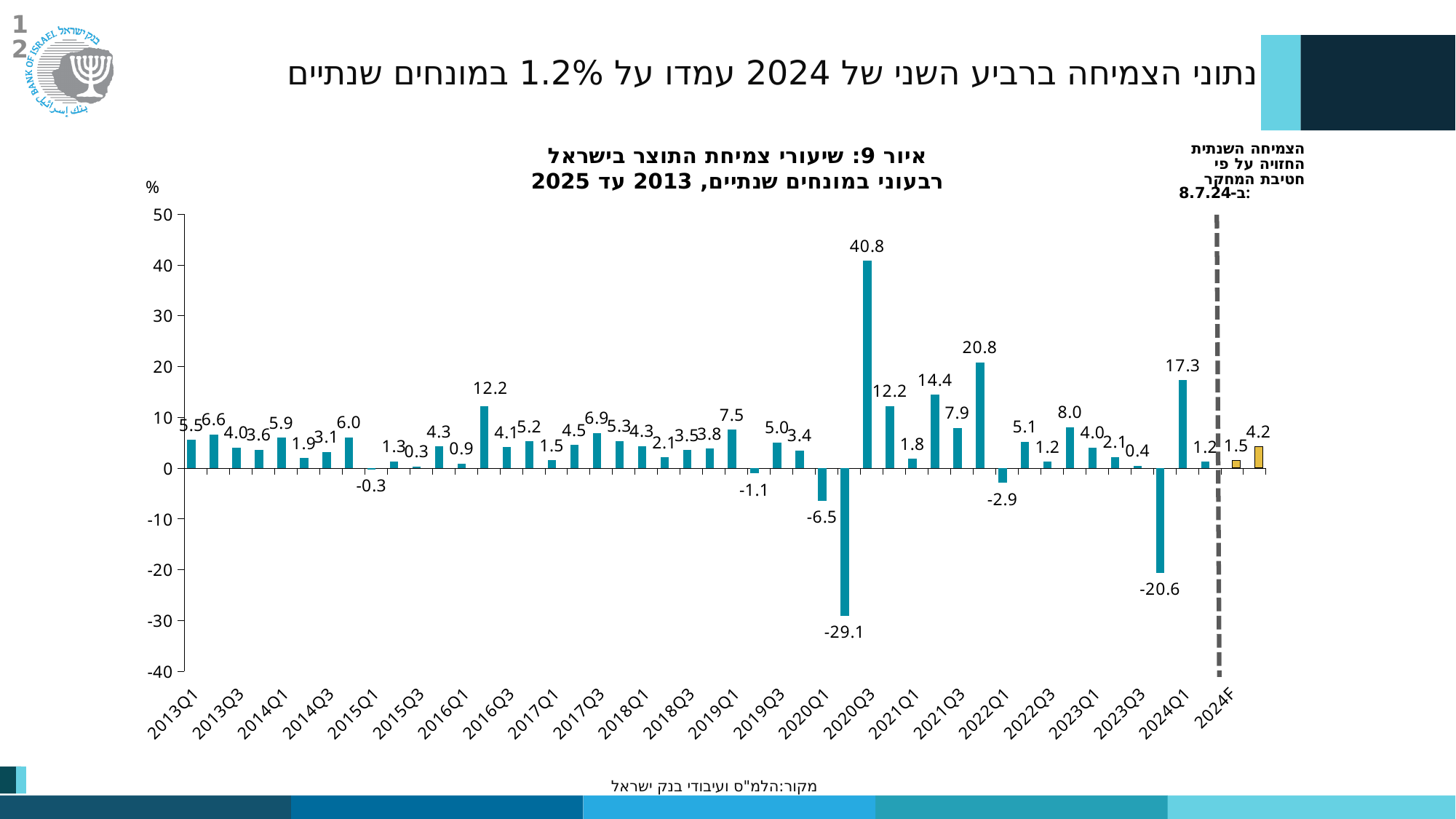
What is the value for 2022Q1? -2.9 What is the value for 2020Q1? -6.5 Which is larger, the value for 2019Q1 or the value for 2021Q3? 2021Q3 What is the value for 2024Q1? 17.3 What is the value for 2024F? 1.5 What is the lowest value shown on the chart? -29.1 What kind of chart is shown? bar chart How many bars on the chart have negative values? 6 What is the value for 2020Q3? 40.8 Which quarter has the highest growth rate? 2020Q3 What is the unit shown on the y axis? % What is the difference between the values for 2024Q1 and 2024F? 15.8